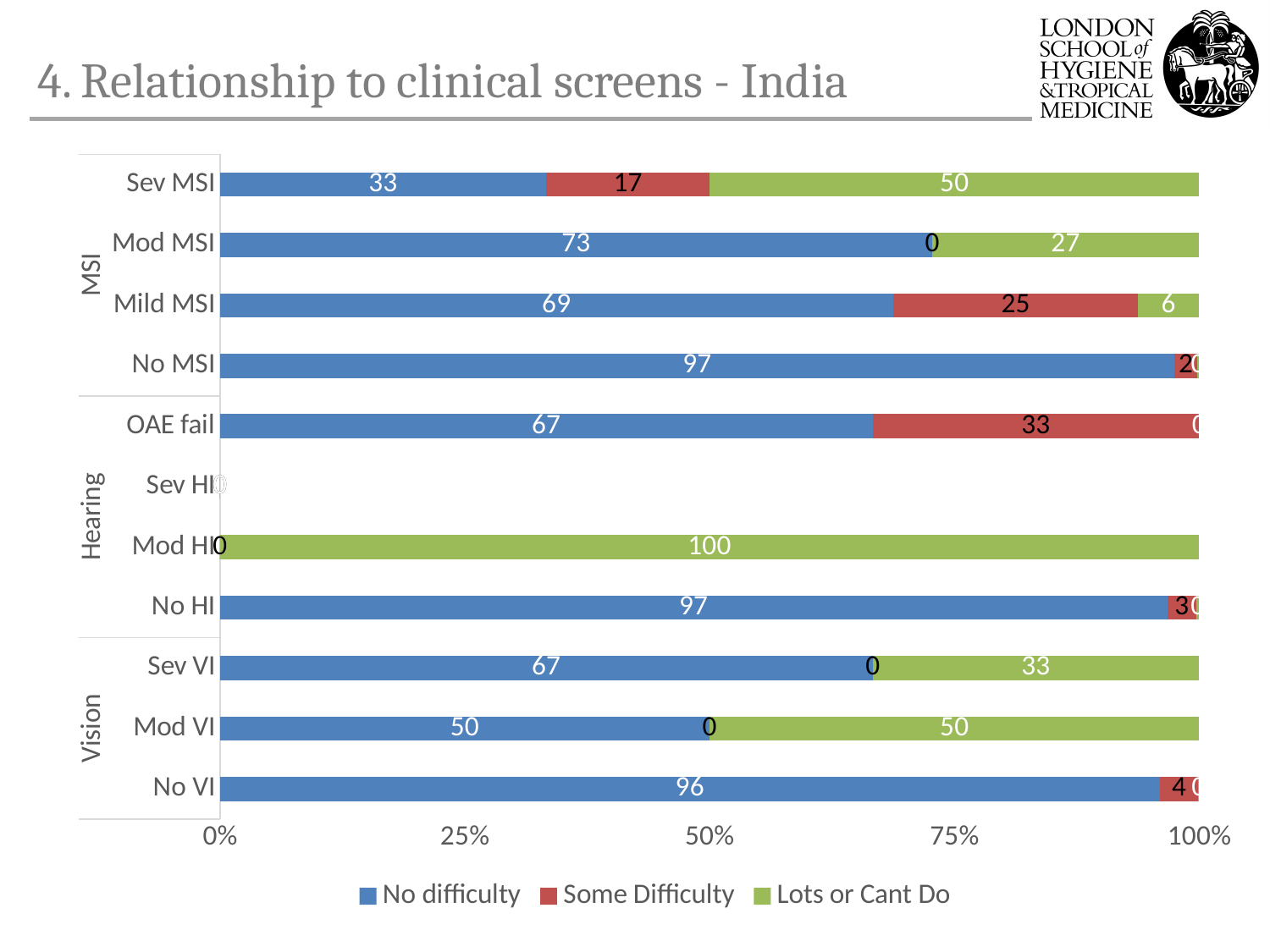
Which has a larger 'No difficulty' value, Mild MSI or Sev VI? Mild MSI Is the 'No difficulty' value for No VI greater or less than 75%? greater What is the difference between the 'No difficulty' values for Mod MSI and Sev MSI? 40 What is the 'Lots or Cant Do' value for Mod HI? 100 Which category has the lowest 'No difficulty' value among the MSI group? Sev MSI What is the 'Some Difficulty' value for OAE fail? 33 Which series is shown in green in the legend? Lots or Cant Do How many series does the legend list? 3 What type of chart is shown on the slide? stacked bar chart What is the 'No difficulty' value for Sev MSI? 33 What is the 'Some Difficulty' value for Mild MSI? 25 What is the 'No difficulty' value for Mod VI? 50